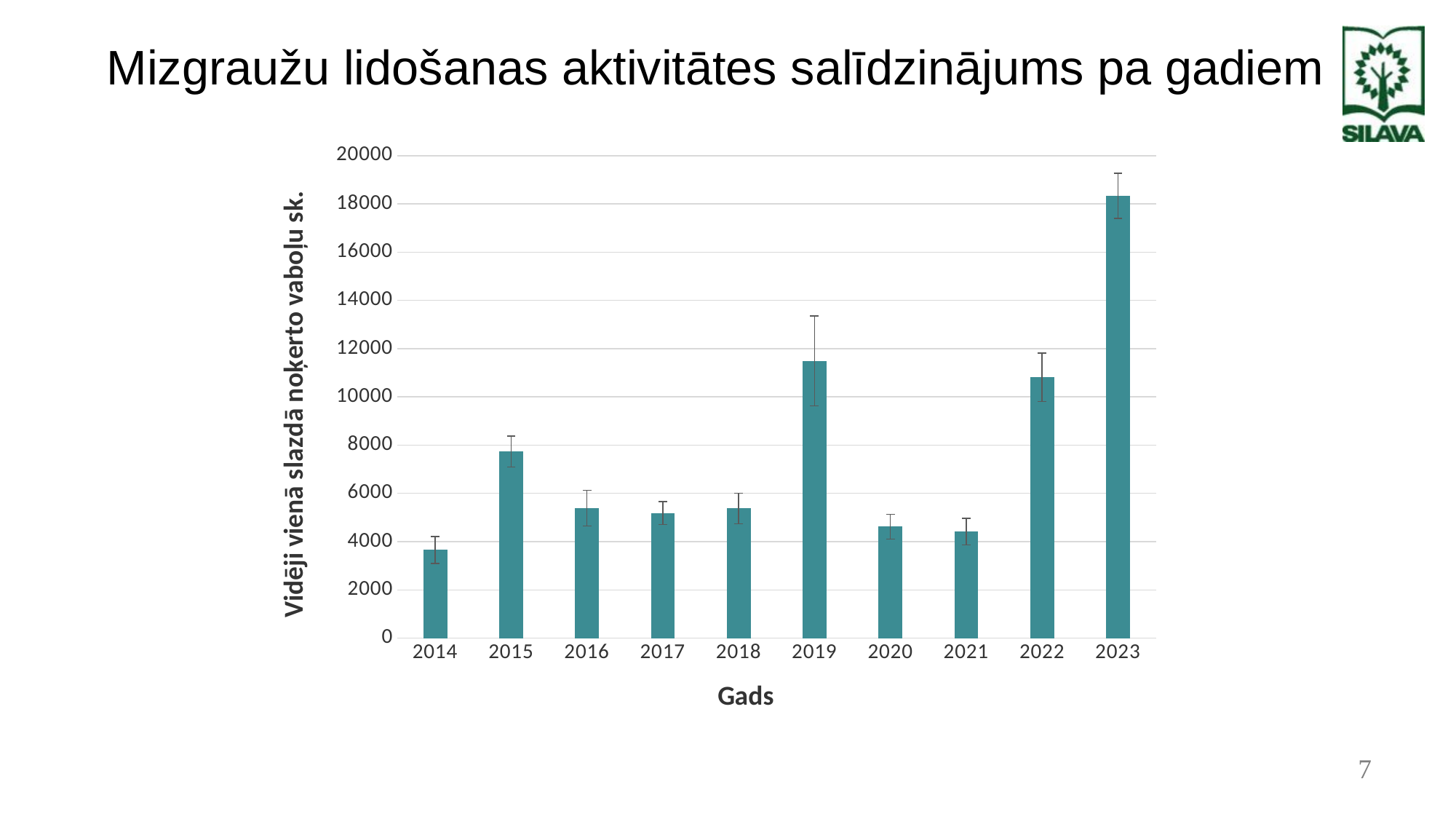
Which year has the lowest bar in the chart? 2014 Is the value for 2023 greater or less than 16000? greater Is the value for 2022 greater or less than 10000? greater How many years are shown on the x axis of the chart? 10 What kind of chart is shown on the slide? bar chart Do the values rise or fall from 2019 to 2021? fall Is the value for 2014 greater or less than 4000? less Which year has the highest bar in the chart? 2023 What is the title of the x axis of the chart? Gads Which year has the larger value, 2015 or 2016? 2015